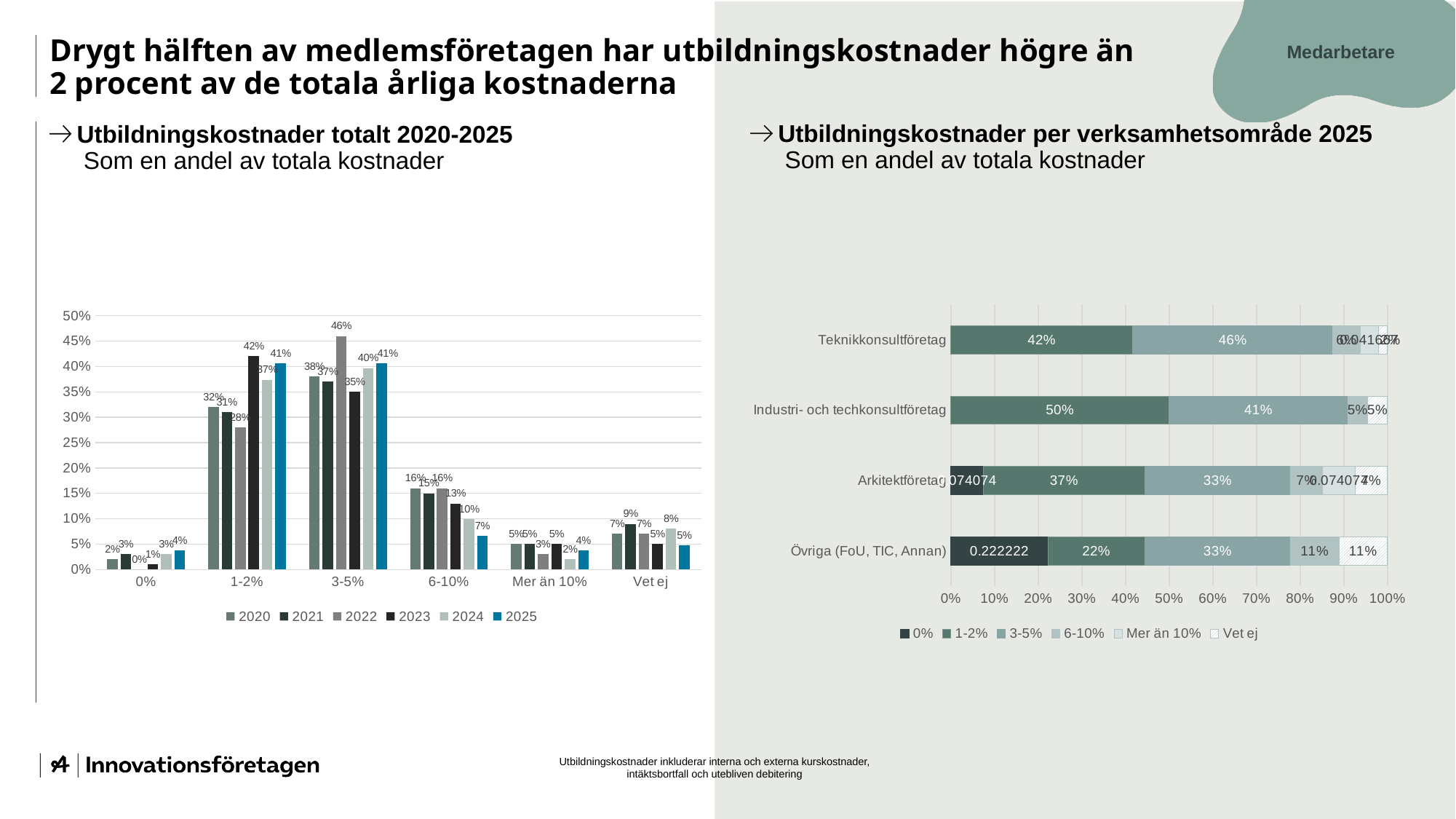
In the left chart (Utbildningskostnader totalt 2020-2025), how many categories are shown on the x axis? 6 In the left chart (Utbildningskostnader totalt 2020-2025), which year has the lowest value in the 0% category? 2022 In the right chart (Utbildningskostnader per verksamhetsområde 2025), what is the 1-2% share for Industri- och techkonsultföretag? 50% In the left chart (Utbildningskostnader totalt 2020-2025), what is the value for 2022 in the 3-5% category? 46% In the right chart (Utbildningskostnader per verksamhetsområde 2025), what is the 3-5% share for Teknikkonsultföretag? 46% What kind of chart is the right chart (Utbildningskostnader per verksamhetsområde 2025)? Stacked horizontal bar chart In the left chart (Utbildningskostnader totalt 2020-2025), do the values for the 6-10% category rise or fall from 2023 to 2025? fall In the left chart (Utbildningskostnader totalt 2020-2025), what is the difference between the 2023 and 2022 values in the 1-2% category? 14 percentage points In the right chart (Utbildningskostnader per verksamhetsområde 2025), which is larger for Arkitektföretag: the 1-2% share or the 3-5% share? 1-2% (37%) In the left chart (Utbildningskostnader totalt 2020-2025), what is the value for 2025 in the 1-2% category? 41% In the left chart (Utbildningskostnader totalt 2020-2025), how many series does the legend list? 6 In the left chart (Utbildningskostnader totalt 2020-2025), which year has the highest value in the 6-10% category? 2020 and 2022 (16%)